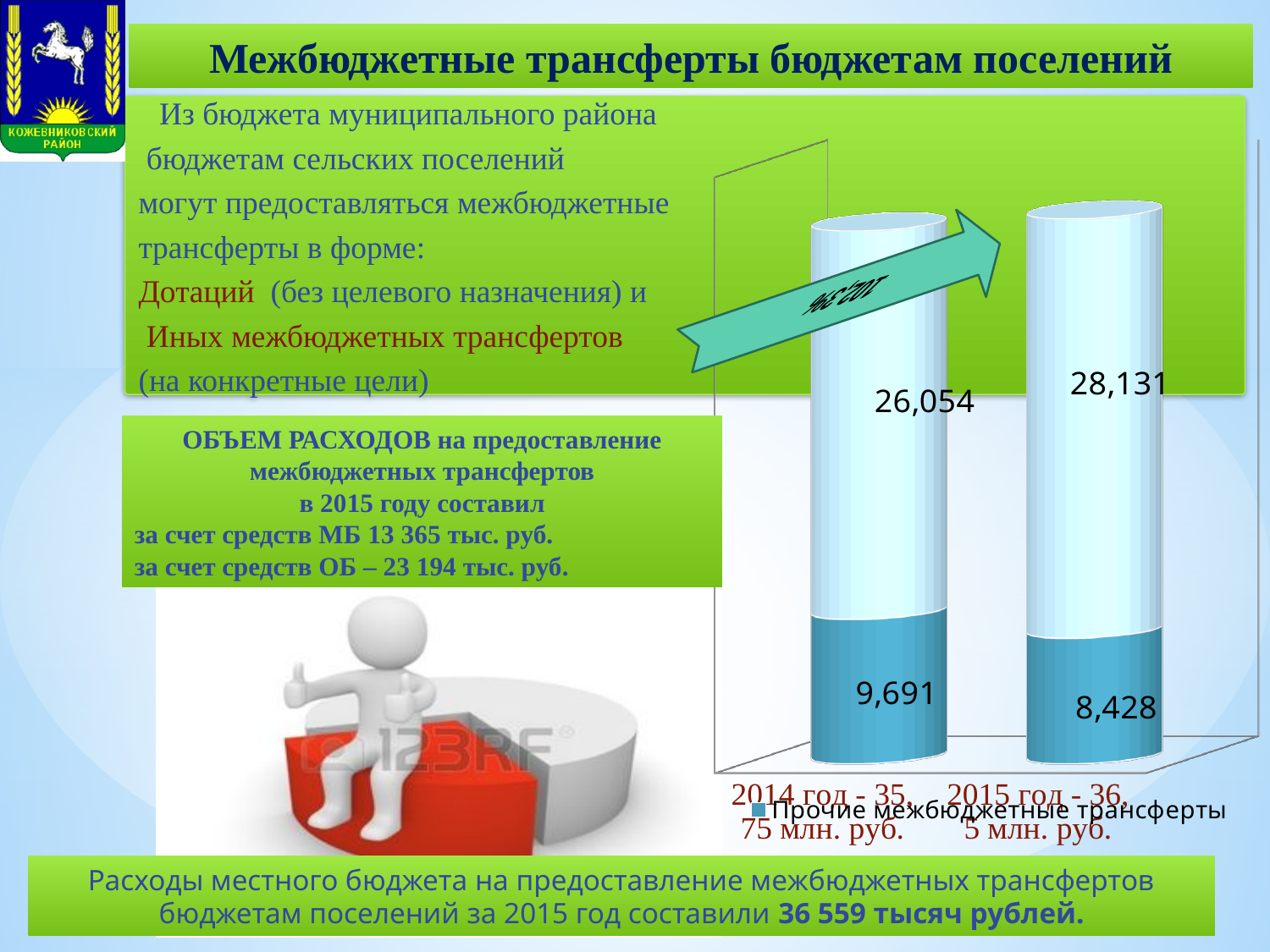
What is the total of the two labelled segments in the 2014 bar? 35,745 What is the difference between the upper segment values of the 2015 and 2014 bars? 2,077 What is the value of the 'Прочие межбюджетные трансферты' series for 2014? 9,691 By how much does the 'Прочие межбюджетные трансферты' value for 2014 exceed the value for 2015? 1,263 How many categories (years) are shown on the chart? 2 What value is labelled on the upper (light blue) segment of the 2014 bar? 26,054 Which year has the larger 'Прочие межбюджетные трансферты' value, 2014 or 2015? 2014 What is the total of the two labelled segments in the 2015 bar? 36,559 Does the upper (light blue) segment value rise or fall from 2014 to 2015? rise What kind of chart is shown on the slide? bar chart What value is labelled on the upper (light blue) segment of the 2015 bar? 28,131 What is the value of the 'Прочие межбюджетные трансферты' series for 2015? 8,428